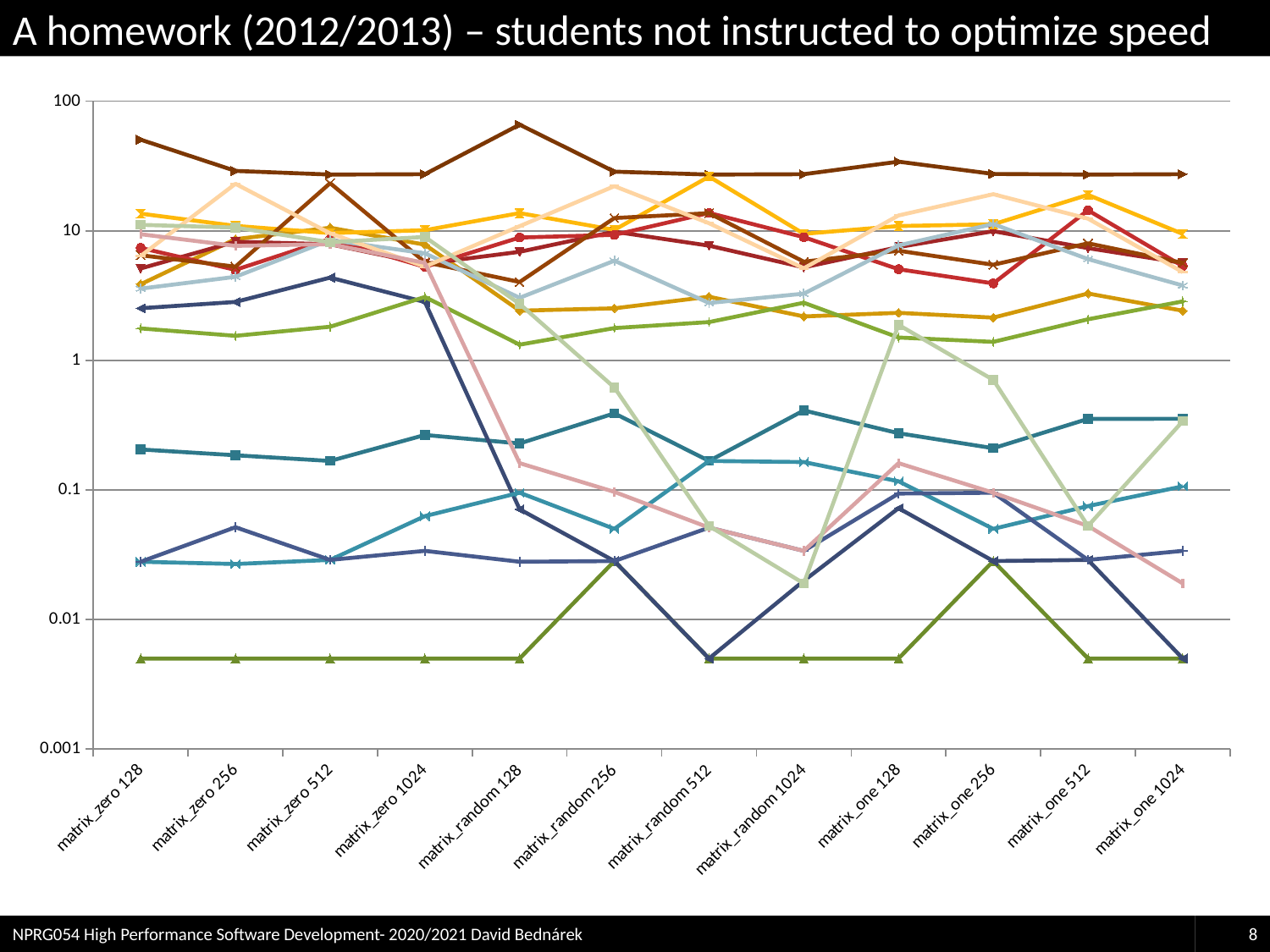
Is the highest plotted value at matrix_random 128 greater or less than 10? greater What is the highest tick value shown on the y axis? 100 Is the highest plotted value at matrix_one 128 greater or less than 10? greater What is the first category on the x axis? matrix_zero 128 At which category does the topmost line reach its highest value? matrix_random 128 What is the title of the slide containing the chart? A homework (2012/2013) – students not instructed to optimize speed What is the last category on the x axis? matrix_one 1024 Is the lowest plotted value at matrix_zero 128 greater or less than 0.01? less How many categories are shown along the x axis? 12 What kind of chart is shown on the slide? line chart